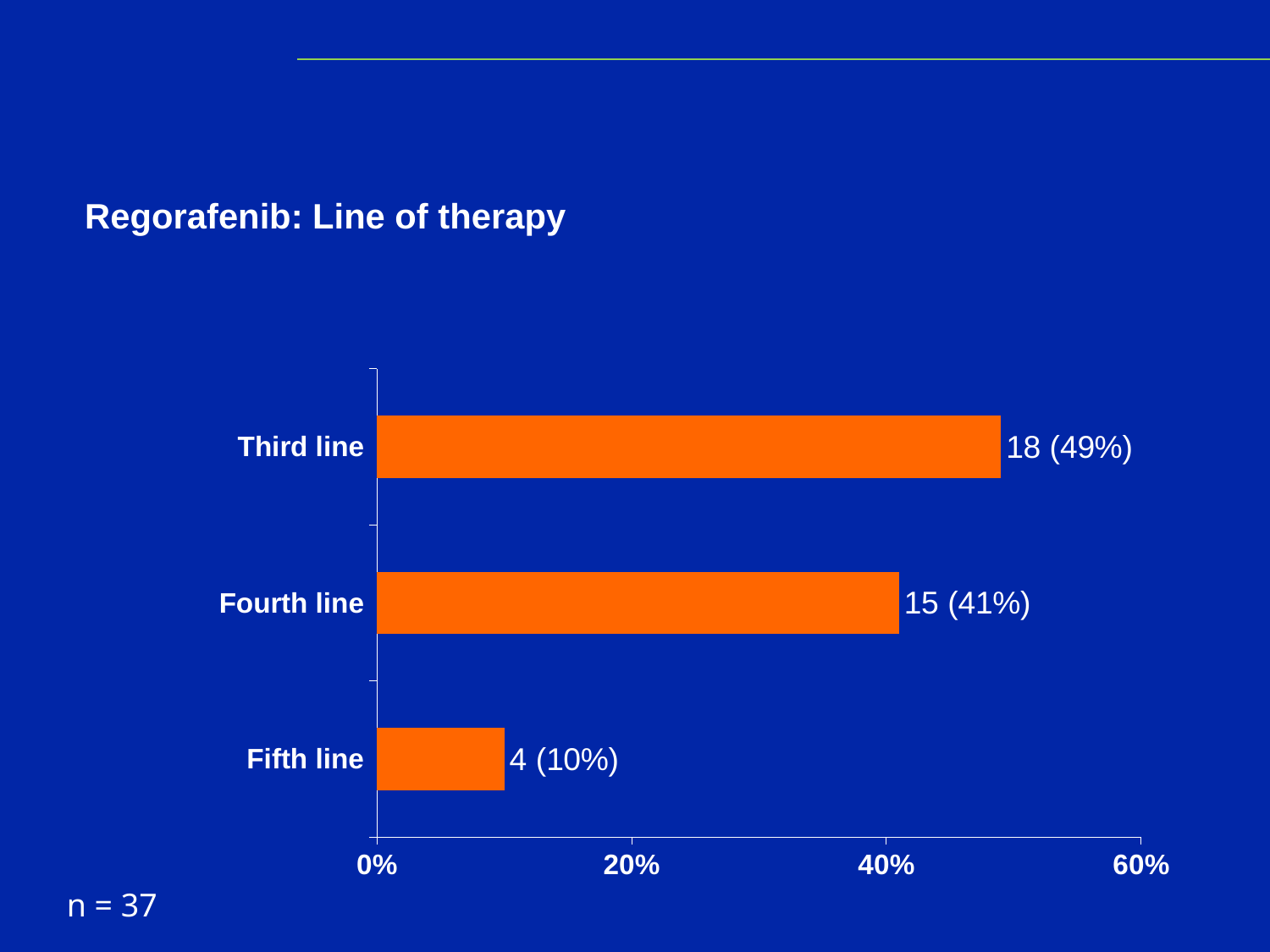
Which line of therapy has the lowest value? Fifth line How many categories are shown in the chart? 3 What is the title of the chart? Regorafenib: Line of therapy What is the data label for Fifth line? 4 (10%) Which line of therapy has the highest value? Third line What is the difference in patient count between Third line and Fourth line? 3 What is the difference in percentage between Fourth line and Fifth line? 31% What is the data label for Fourth line? 15 (41%) What is the data label for Third line? 18 (49%) Is the value for Fourth line greater or less than 40%? greater What kind of chart is shown on the slide? Bar chart Which is larger, the value for Fourth line or Fifth line? Fourth line